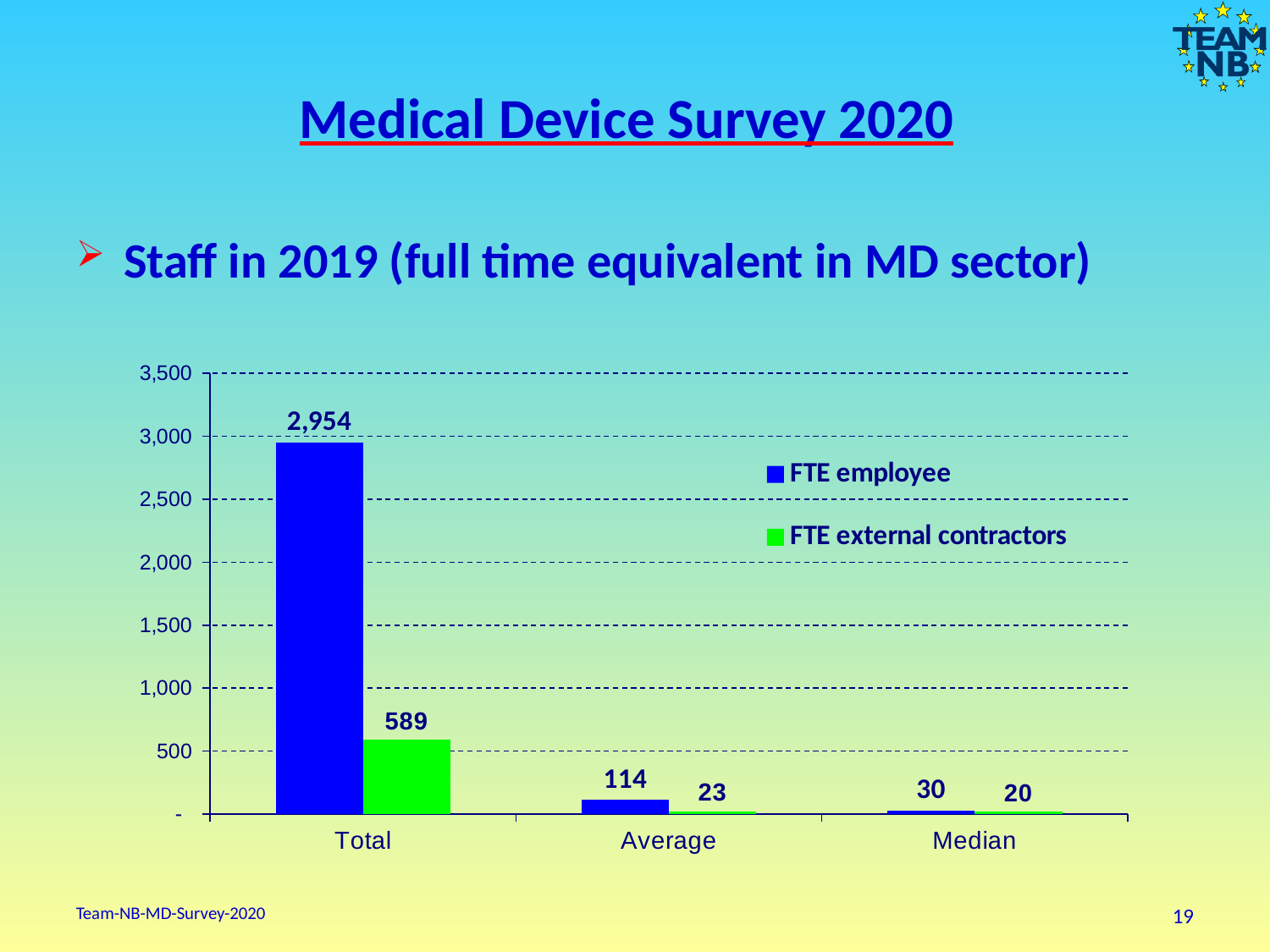
What is the FTE employee value for Total? 2,954 What is the difference between the FTE employee and FTE external contractors values for Total? 2,365 How many series does the legend list? 2 What is the FTE external contractors value for Total? 589 Which category has the lowest FTE external contractors value? Median What is the FTE employee value for Average? 114 Which category has the highest FTE employee value? Total Which is larger for Median: FTE employee or FTE external contractors? FTE employee What kind of chart is shown on the slide? Bar chart What is the difference between the FTE employee and FTE external contractors values for Average? 91 How many categories are shown on the x axis? 3 What is the FTE external contractors value for Median? 20